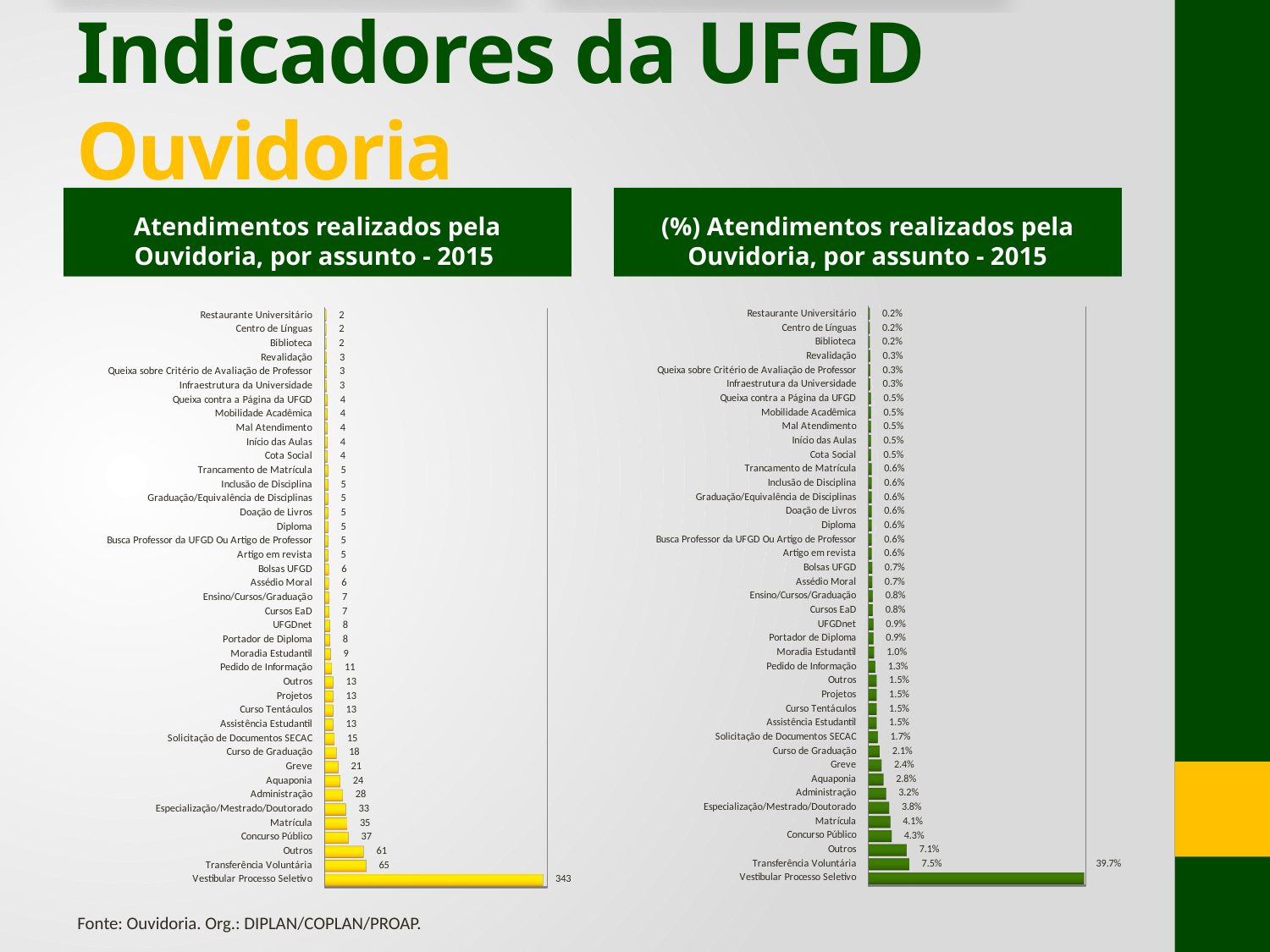
In the chart '(%) Atendimentos realizados pela Ouvidoria, por assunto - 2015', what percentage is shown for Vestibular Processo Seletivo? 39.7% In the chart '(%) Atendimentos realizados pela Ouvidoria, por assunto - 2015', what percentage is shown for Administração? 3.2% What colour are the bars in the chart 'Atendimentos realizados pela Ouvidoria, por assunto - 2015' on the left? Yellow In the chart 'Atendimentos realizados pela Ouvidoria, por assunto - 2015', what is the difference between Vestibular Processo Seletivo and Transferência Voluntária? 278 In the chart 'Atendimentos realizados pela Ouvidoria, por assunto - 2015', what is the value for Transferência Voluntária? 65 In the chart 'Atendimentos realizados pela Ouvidoria, por assunto - 2015', which subject has the highest number of atendimentos? Vestibular Processo Seletivo In the chart 'Atendimentos realizados pela Ouvidoria, por assunto - 2015', which is larger: Greve or Aquaponia? Aquaponia In the chart 'Atendimentos realizados pela Ouvidoria, por assunto - 2015', how many atendimentos are shown for Vestibular Processo Seletivo? 343 In the chart '(%) Atendimentos realizados pela Ouvidoria, por assunto - 2015', what is the difference between Transferência Voluntária and Outros (7.1%)? 0.4% In the chart 'Atendimentos realizados pela Ouvidoria, por assunto - 2015', what is the value for Concurso Público? 37 How many subject categories are listed in the chart 'Atendimentos realizados pela Ouvidoria, por assunto - 2015'? 41 What type of chart is used in '(%) Atendimentos realizados pela Ouvidoria, por assunto - 2015'? Bar chart